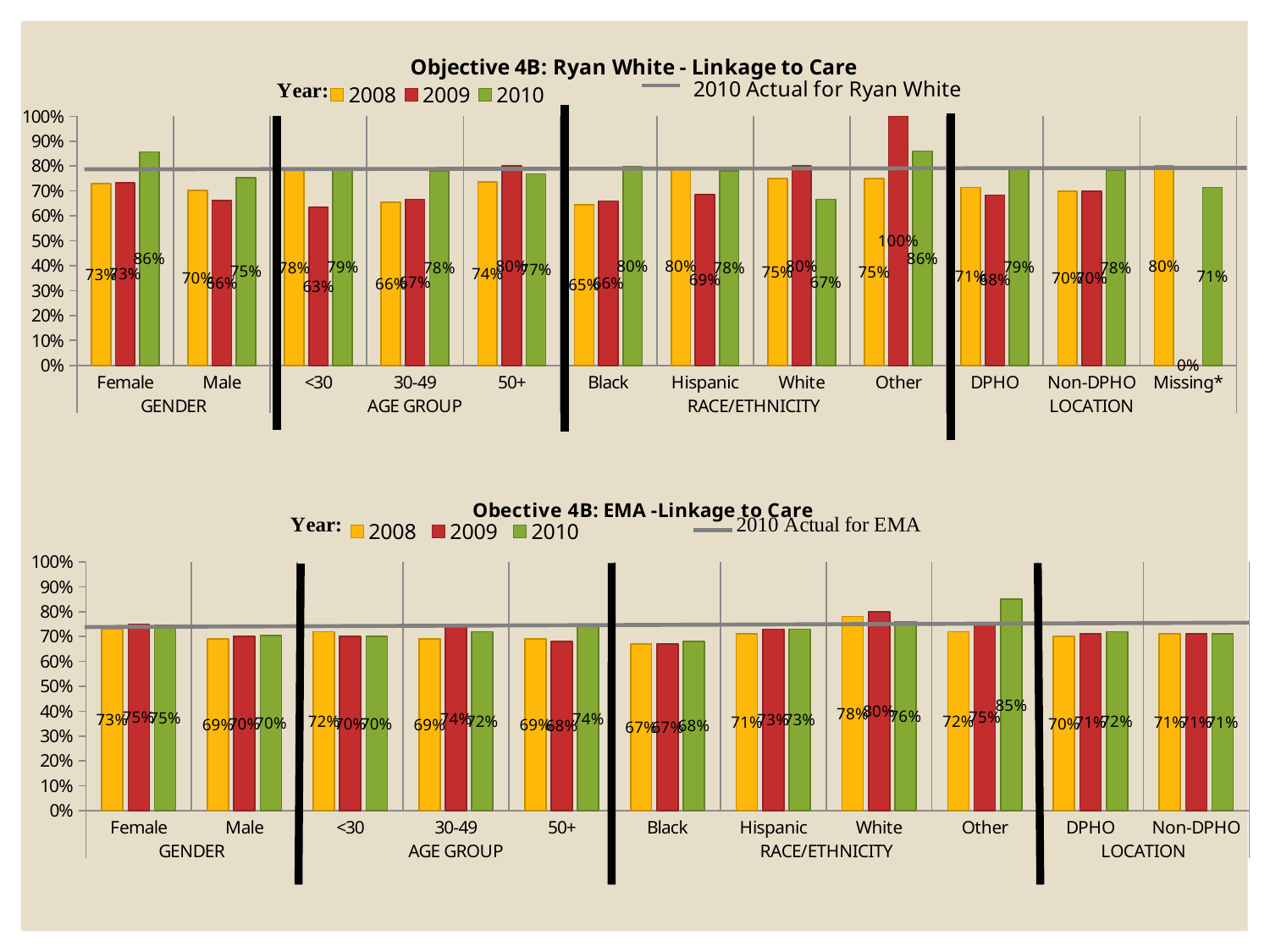
In the Ryan White - Linkage to Care chart, which category has the highest 2009 value? Other How many series does the legend of the Ryan White - Linkage to Care chart list, excluding the 2010 Actual line? 3 In the Ryan White - Linkage to Care chart, what is the 2009 value for Missing*? 0% What type of chart is the EMA - Linkage to Care chart? Bar chart In the EMA - Linkage to Care chart, what is the 2009 value for 30-49? 74% In the Ryan White - Linkage to Care chart, which is larger for White: the 2009 value or the 2010 value? 2009 In the Ryan White - Linkage to Care chart, what is the 2009 value for Other under Race/Ethnicity? 100% In the EMA - Linkage to Care chart, what is the 2010 value for Other under Race/Ethnicity? 85% In the Ryan White - Linkage to Care chart, what is the 2010 value for Female? 86% How many categories are shown on the x axis of the EMA - Linkage to Care chart? 11 In the EMA - Linkage to Care chart, which category has the lowest 2008 value? Black In the Ryan White - Linkage to Care chart, what is the difference between the 2010 and 2009 values for <30? 16%